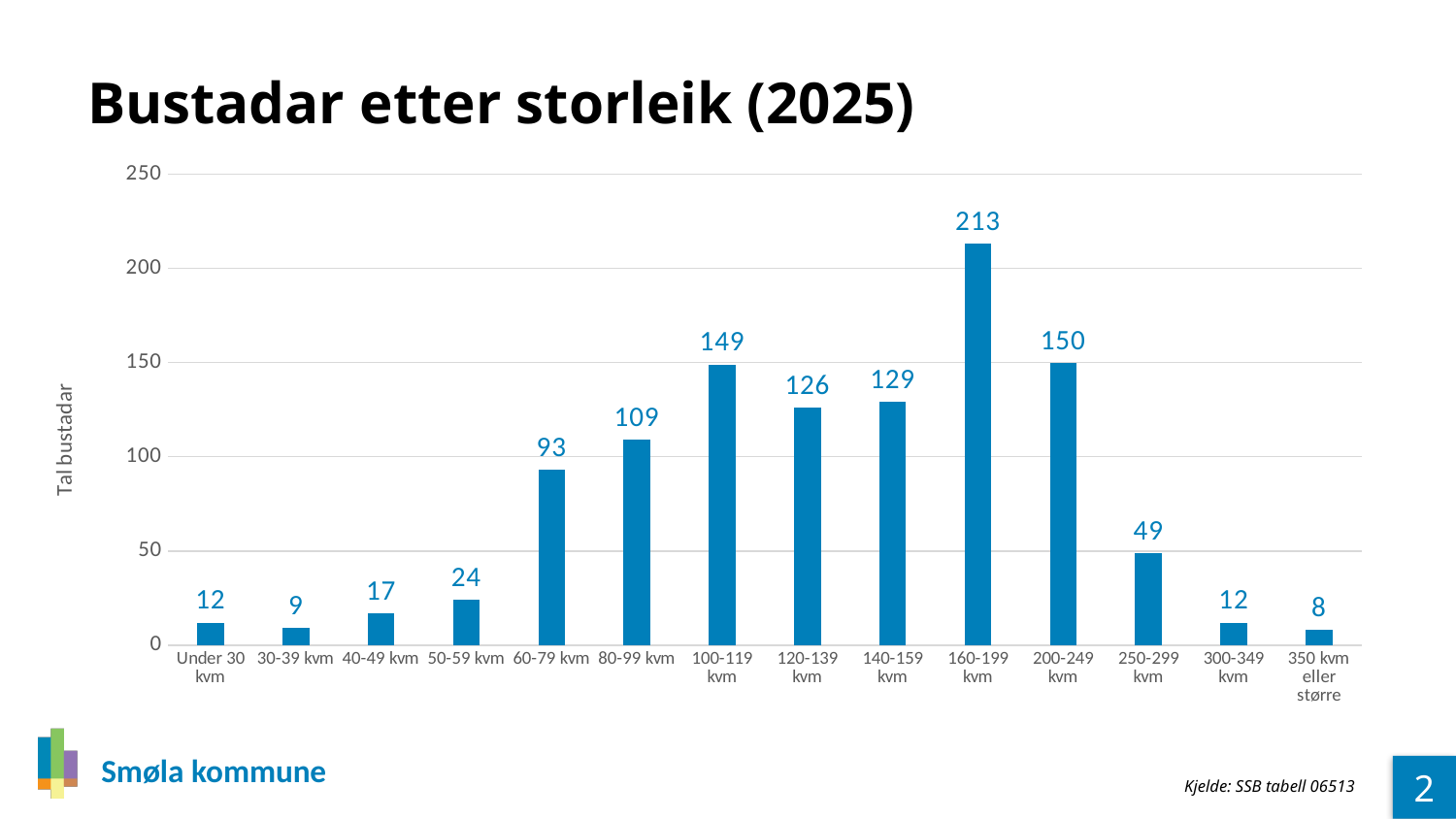
Which category has the lowest value? 350 kvm eller større What kind of chart is shown on the slide? bar chart Is the value for 80-99 kvm greater or less than 100? greater What is the title of the chart? Bustadar etter storleik (2025) Which category has the highest value? 160-199 kvm What is the value for the 350 kvm eller større category? 8 What is the difference between the values for 160-199 kvm and 200-249 kvm? 63 What is the value for the 160-199 kvm category? 213 What is the label on the y axis? Tal bustadar Which is larger, the value for 100-119 kvm or the value for 140-159 kvm? 100-119 kvm What is the value for the 60-79 kvm category? 93 How many categories are shown on the x axis? 14